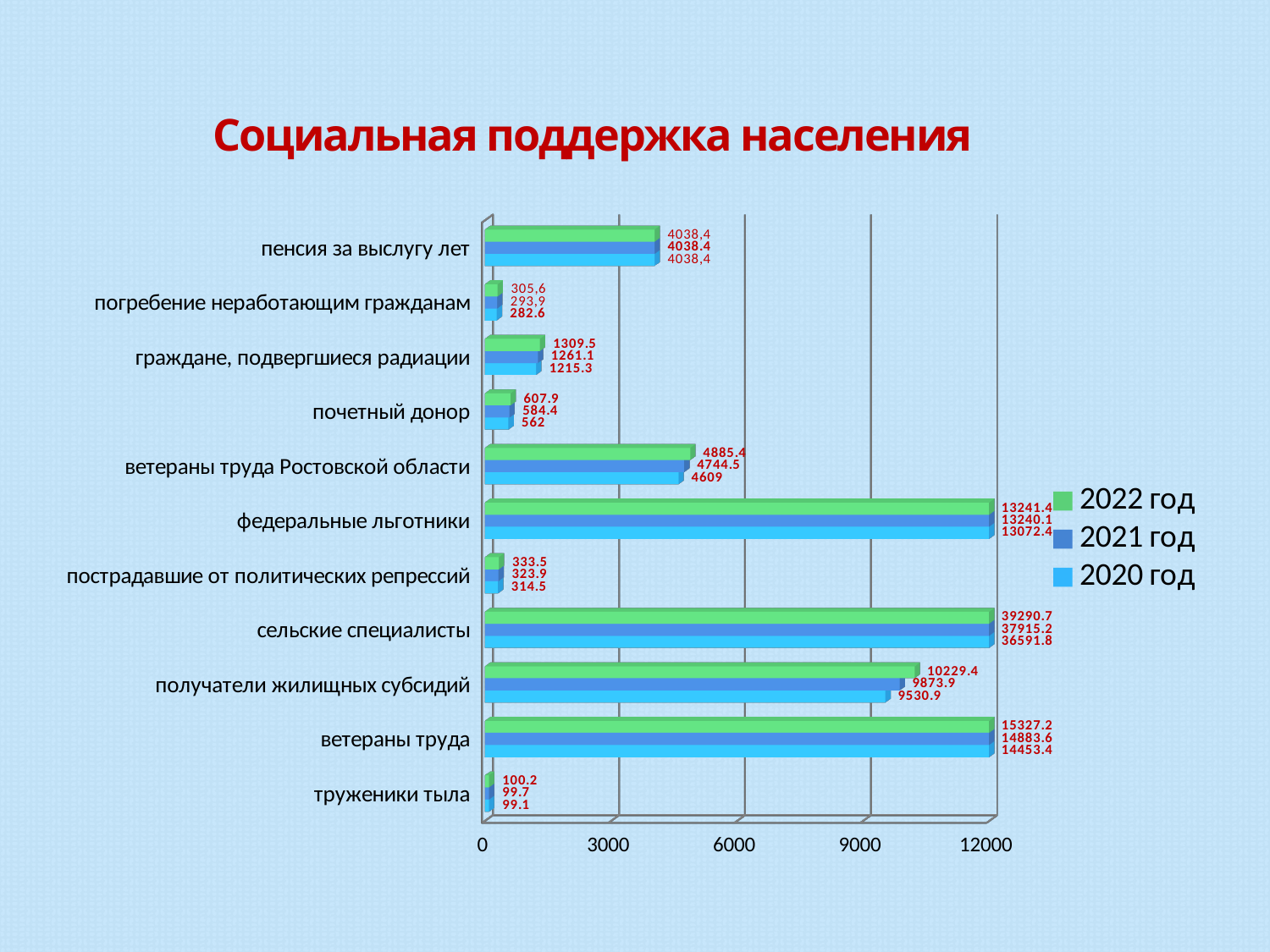
Is the 2022 год value for ветераны труда Ростовской области greater or less than 3000? greater Which is larger for 2022 год: получатели жилищных субсидий or федеральные льготники? федеральные льготники Which category has the lowest value for 2022 год? труженики тыла How many categories are plotted on the chart? 11 What kind of chart is shown on the slide? bar chart Which category has the highest value for 2022 год? сельские специалисты What is the value for почетный донор in 2020 год? 562 What is the value for сельские специалисты in 2022 год? 39290.7 What is the value for труженики тыла in 2021 год? 99.7 What is the title of the slide? Социальная поддержка населения How many series does the legend list? 3 What is the difference between the 2022 год and 2020 год values for ветераны труда? 873.8